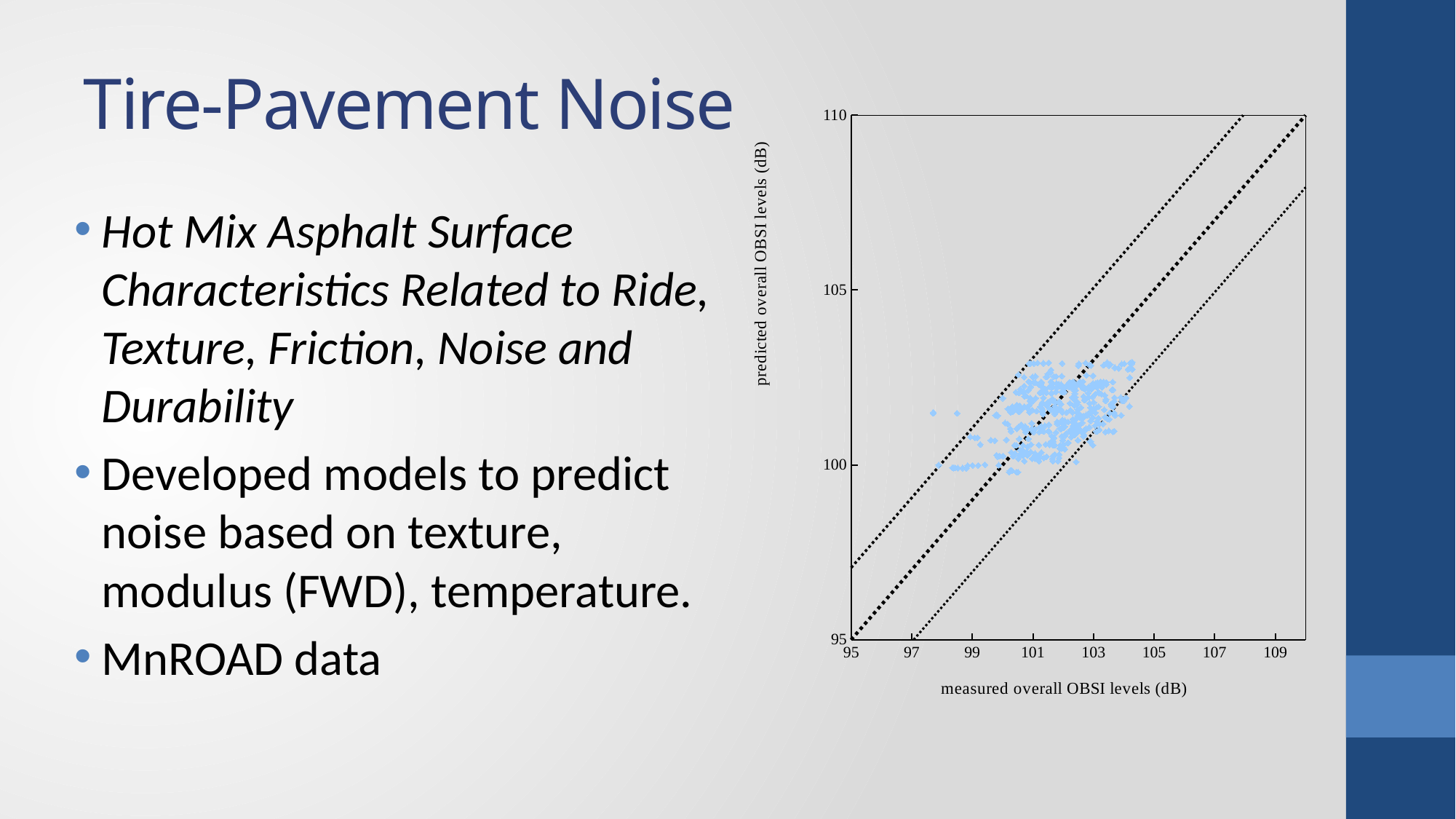
What is the title of the x axis of the chart? measured overall OBSI levels (dB) What is the title of the y axis of the chart? predicted overall OBSI levels (dB) What kind of chart is shown on the slide? scatter chart Is the highest measured overall OBSI level among the plotted points greater or less than 107? less Is the lowest measured overall OBSI level among the plotted points greater or less than 97? greater Is the highest predicted overall OBSI level among the plotted points greater or less than 105? less